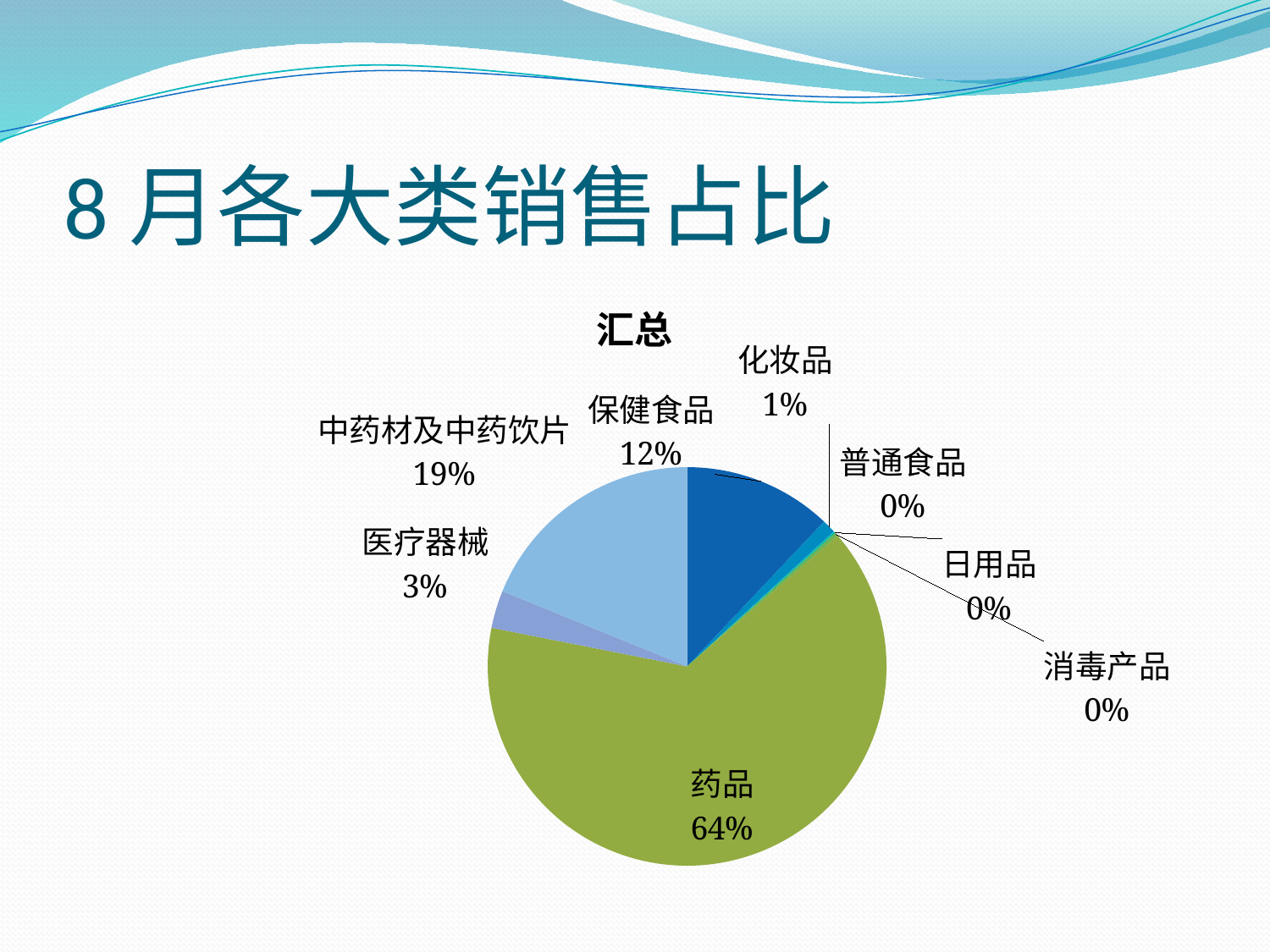
What share of the pie does 保健食品 have? 12% Which category has the largest share of the pie? 药品 What share of the pie does 中药材及中药饮片 have? 19% How many categories are shown in the pie chart? 8 What is the value shown for 化妆品? 1% What kind of chart is shown on the slide? pie chart What is the title of the chart? 汇总 What is the value shown for 消毒产品? 0% Which has a larger share, 保健食品 or 医疗器械? 保健食品 What is the value shown for 医疗器械? 3% What share of the pie does 药品 have? 64% What is the difference between the shares of 药品 and 中药材及中药饮片? 45%